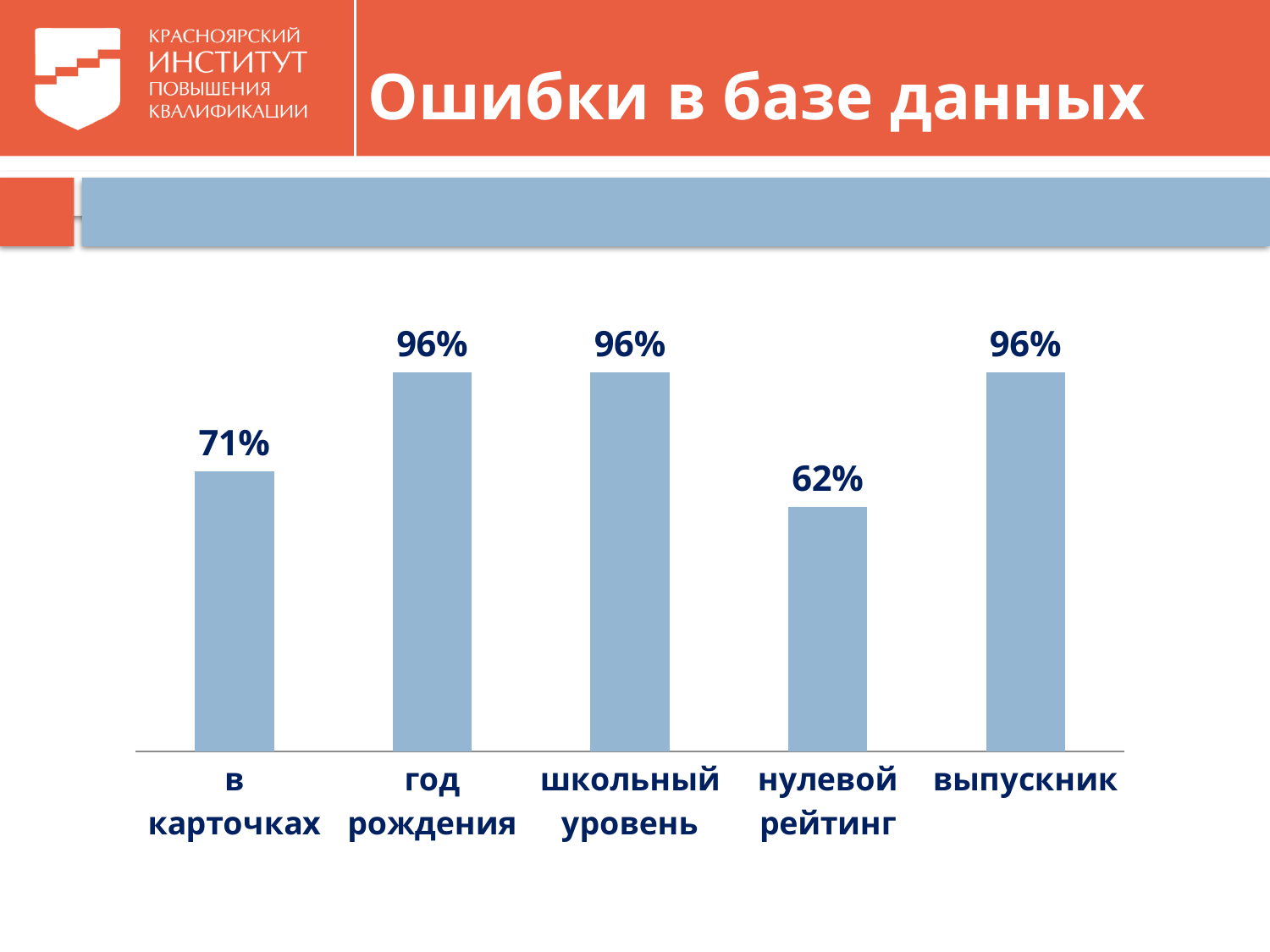
What is the value for "выпускник"? 96% What is the value for "год рождения"? 96% What is the difference between the values for "в карточках" and "нулевой рейтинг"? 9 percentage points Which is larger, the value for "в карточках" or the value for "нулевой рейтинг"? в карточках What kind of chart is shown on the slide? bar chart Which category has the lowest value? нулевой рейтинг What is the value for "в карточках"? 71% What is the title of the slide containing the chart? Ошибки в базе данных What is the value for "школьный уровень"? 96% What is the value for "нулевой рейтинг"? 62% What is the difference between the values for "год рождения" and "в карточках"? 25 percentage points How many categories are shown in the chart? 5